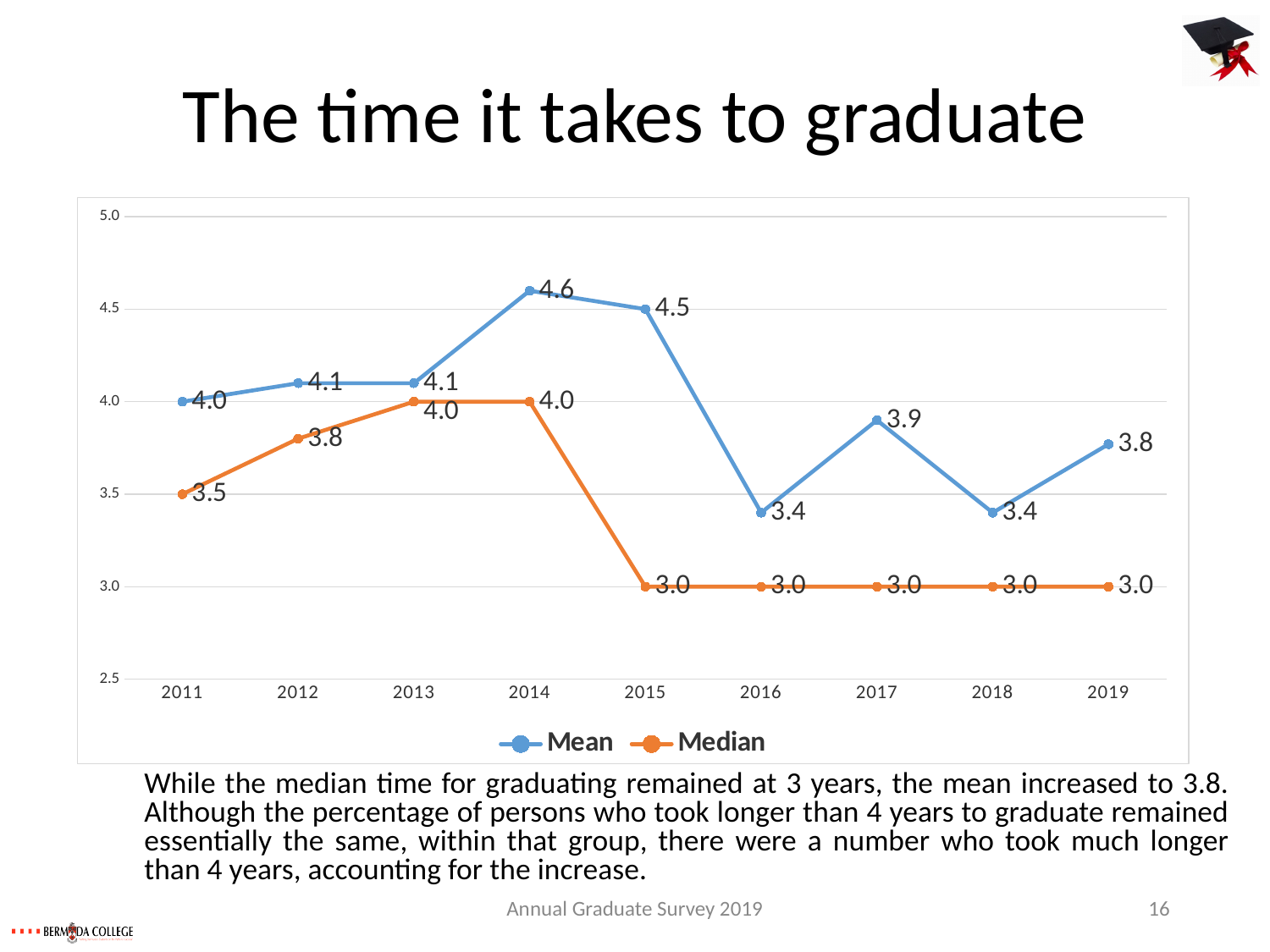
What is the Mean value for 2014? 4.6 Which series is drawn in orange? Median What is the difference between the Mean and the Median in 2015? 1.5 What is the lowest Median value shown? 3.0 How many years are plotted along the x axis? 9 How many series does the legend list? 2 What kind of chart is shown on the slide? Line chart In which year is the Mean highest? 2014 What is the Mean value for 2019? 3.8 Does the Median rise or fall from 2014 to 2015? Fall Which is larger in 2013, the Mean or the Median? Mean What is the Median value for 2011? 3.5